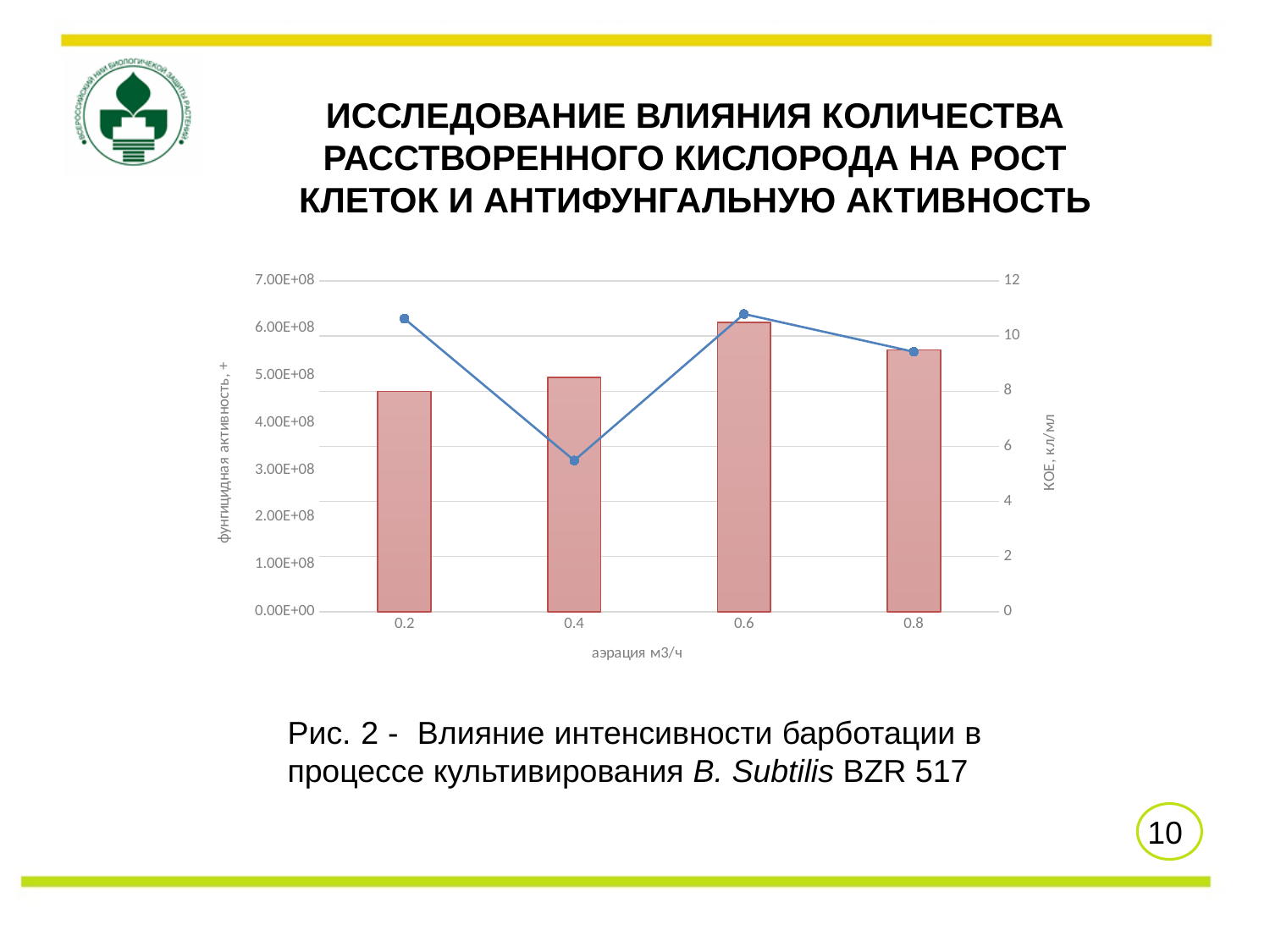
What kind of chart is shown on the slide? A combination bar and line chart How many aeration categories are shown on the x axis of the chart? 4 Is the bar value for aeration 0.6 greater or less than 5.00E+08? greater Is the bar value for aeration 0.2 greater or less than 5.00E+08? less Is the line value (КОЕ) for aeration 0.4 greater or less than 6? less What is the title of the x axis of the chart? аэрация м3/ч At which aeration value is the bar the tallest? 0.6 Which line point (КОЕ) is higher, the one at aeration 0.2 or the one at aeration 0.8? 0.2 Does the line (КОЕ) rise or fall between aeration 0.2 and 0.4? fall Which bar is taller, the one for aeration 0.8 or the one for aeration 0.4? 0.8 At which aeration value is the line point (КОЕ) the lowest? 0.4